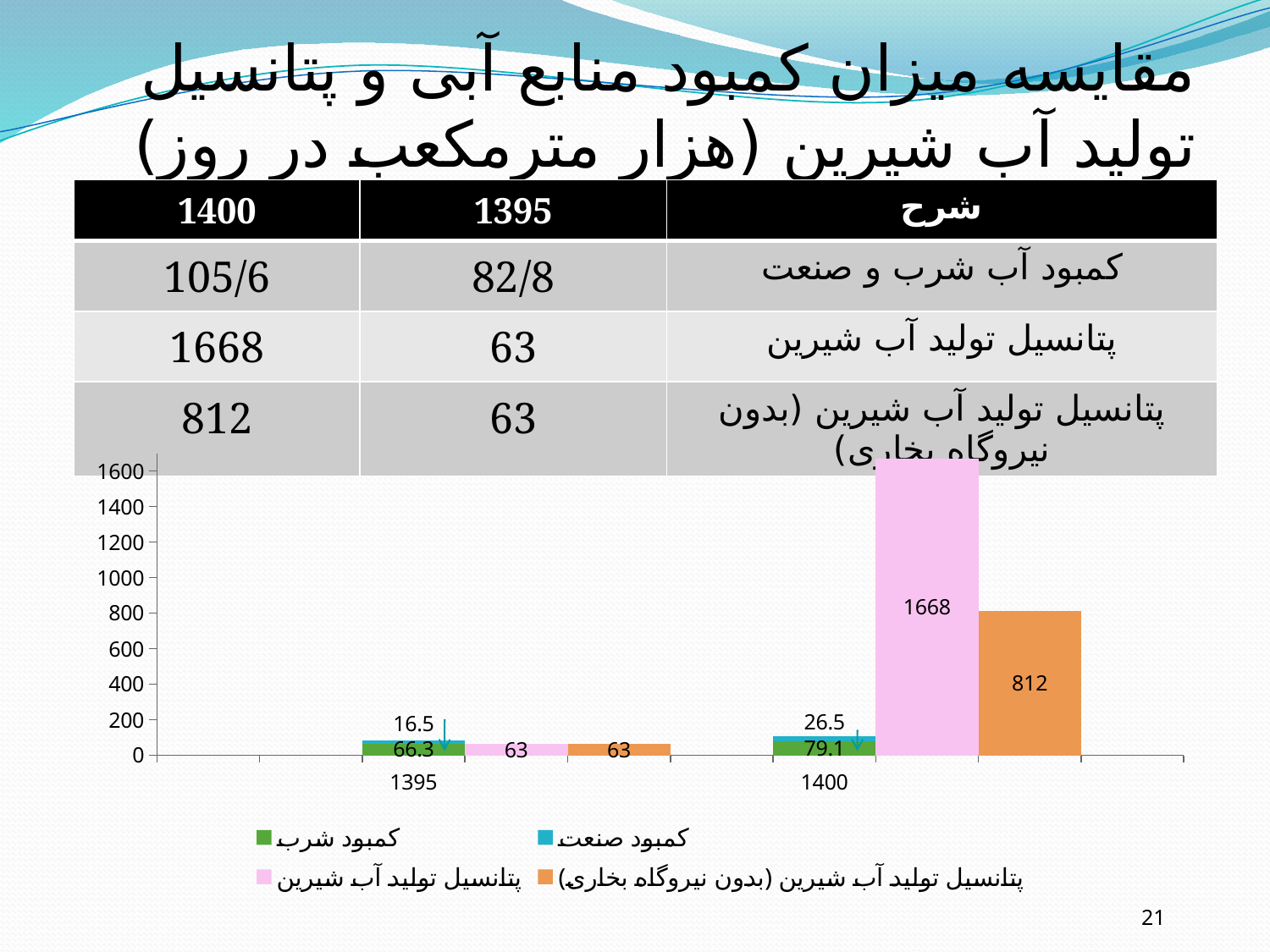
Is the value of کمبود شرب for 1400 larger or smaller than for 1395 in the chart? larger What is the value of کمبود صنعت for 1400 in the chart? 26.5 Which series has the highest value for 1400 in the chart? پتانسیل تولید آب شیرین What is the value of پتانسیل تولید آب شیرین for 1395 in the chart? 63 How many series does the chart legend list? 4 What is the difference between پتانسیل تولید آب شیرین and پتانسیل تولید آب شیرین (بدون نیروگاه بخاری) for 1400 in the chart? 856 What is the value of پتانسیل تولید آب شیرین for 1400 in the chart? 1668 How many year categories are shown on the x axis of the chart? 2 Does the value of پتانسیل تولید آب شیرین rise or fall from 1395 to 1400 in the chart? rise What is the value of کمبود شرب for 1395 in the chart? 66.3 What type of chart is shown on the slide? bar chart What is the value of پتانسیل تولید آب شیرین (بدون نیروگاه بخاری) for 1400 in the chart? 812